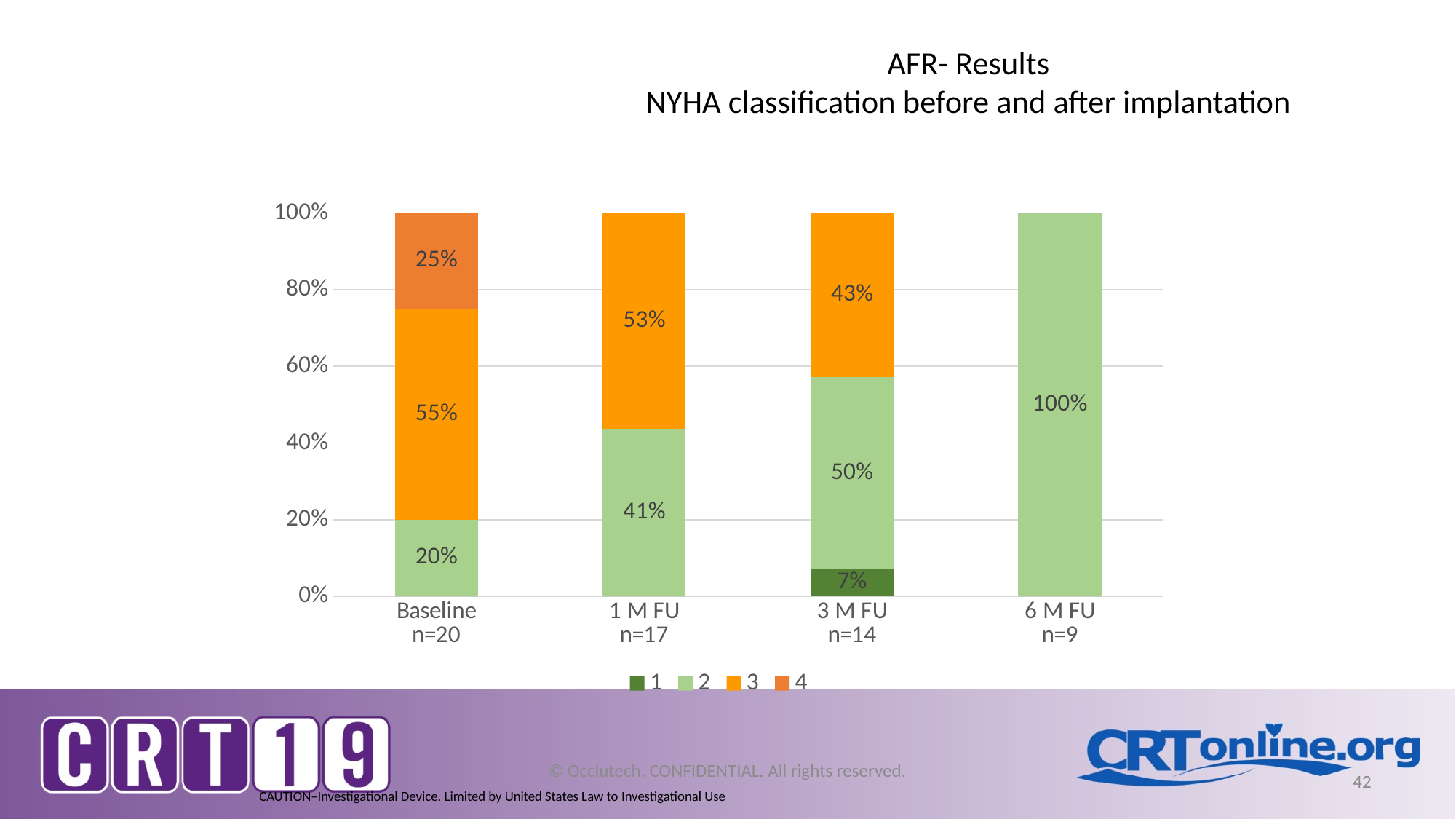
What is the value for NYHA class 2 at 1 M FU? 41% At which time point is the share of NYHA class 2 highest? 6 M FU How many time points are shown on the x axis? 4 How many series does the legend list? 4 What is the difference between the NYHA class 3 values at 1 M FU and 3 M FU? 10% Which is larger: the NYHA class 2 value at Baseline or at 3 M FU? 3 M FU What is the value for NYHA class 1 at 3 M FU? 7% What is the value for NYHA class 4 at Baseline? 25% What is the value for NYHA class 3 at Baseline? 55% What kind of chart is shown on the slide? Stacked bar chart What is the sample size (n) shown for the 3 M FU time point? n=14 What is the value for NYHA class 2 at 6 M FU? 100%